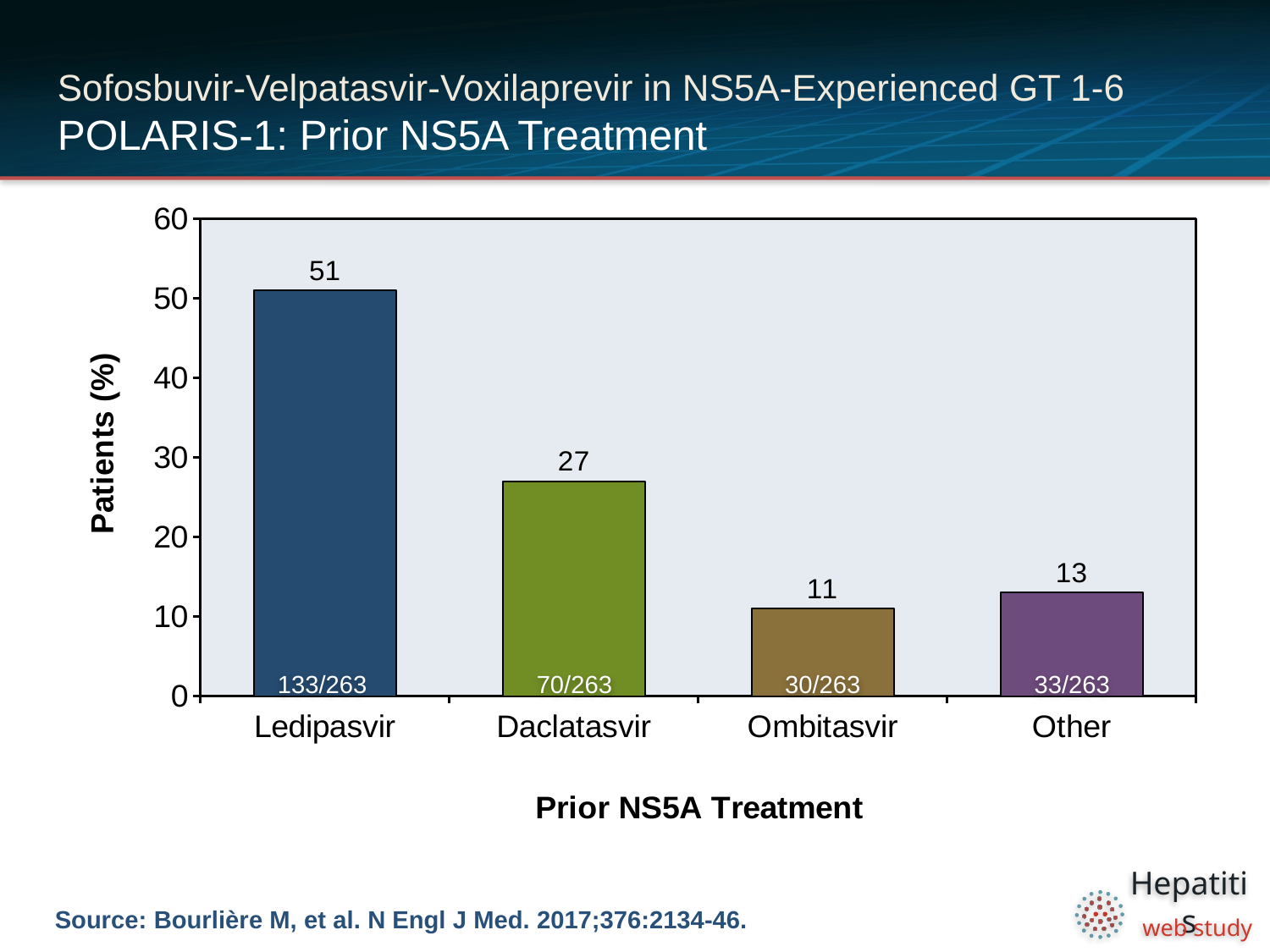
What is the difference in percentage points between Ledipasvir and Daclatasvir? 24 What percentage of patients had prior Daclatasvir treatment? 27 What percentage of patients had prior Ledipasvir treatment? 51 What fraction of patients is shown inside the Other bar? 33/263 What is the label of the y axis? Patients (%) How many prior NS5A treatment categories are shown on the x axis? 4 Which has a higher percentage of patients, Ombitasvir or Other? Other Which prior NS5A treatment has the lowest percentage of patients? Ombitasvir What kind of chart is shown on the slide? bar chart Which prior NS5A treatment has the highest percentage of patients? Ledipasvir Is the value for Daclatasvir greater or less than 30? less What percentage of patients had prior Ombitasvir treatment? 11